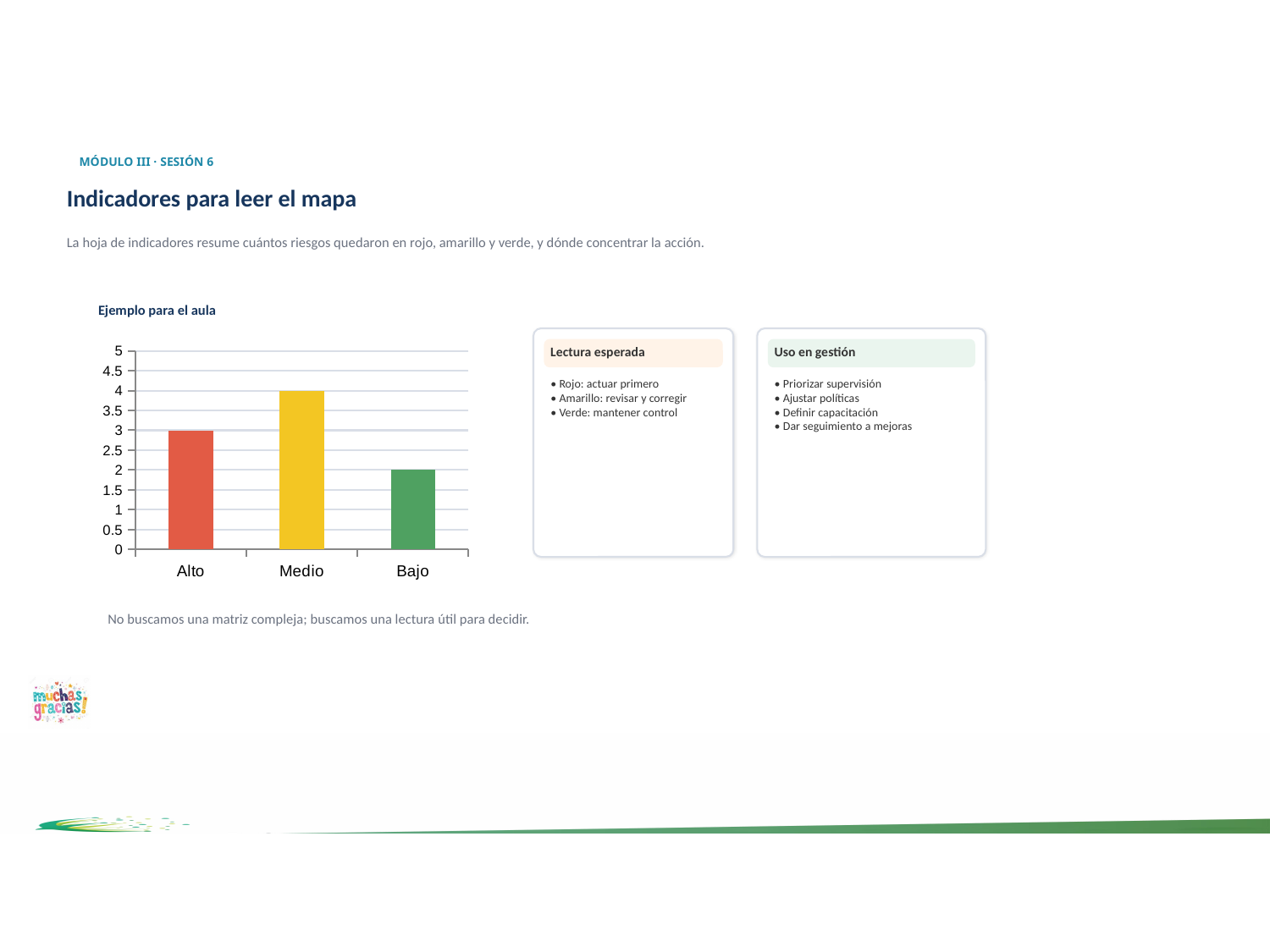
Is the value for Medio greater or less than 3.5? greater Which is larger, the value for Alto or the value for Bajo? Alto Which category has the lowest value? Bajo What is the difference between the values for Medio and Alto? 1 How many categories are shown on the x axis? 3 What is the value for Alto? 3 What is the value for Medio? 4 What is the value for Bajo? 2 Which category has the highest value? Medio What colour is the bar for Bajo? green What is the difference between the values for Medio and Bajo? 2 What kind of chart is shown on the slide? bar chart